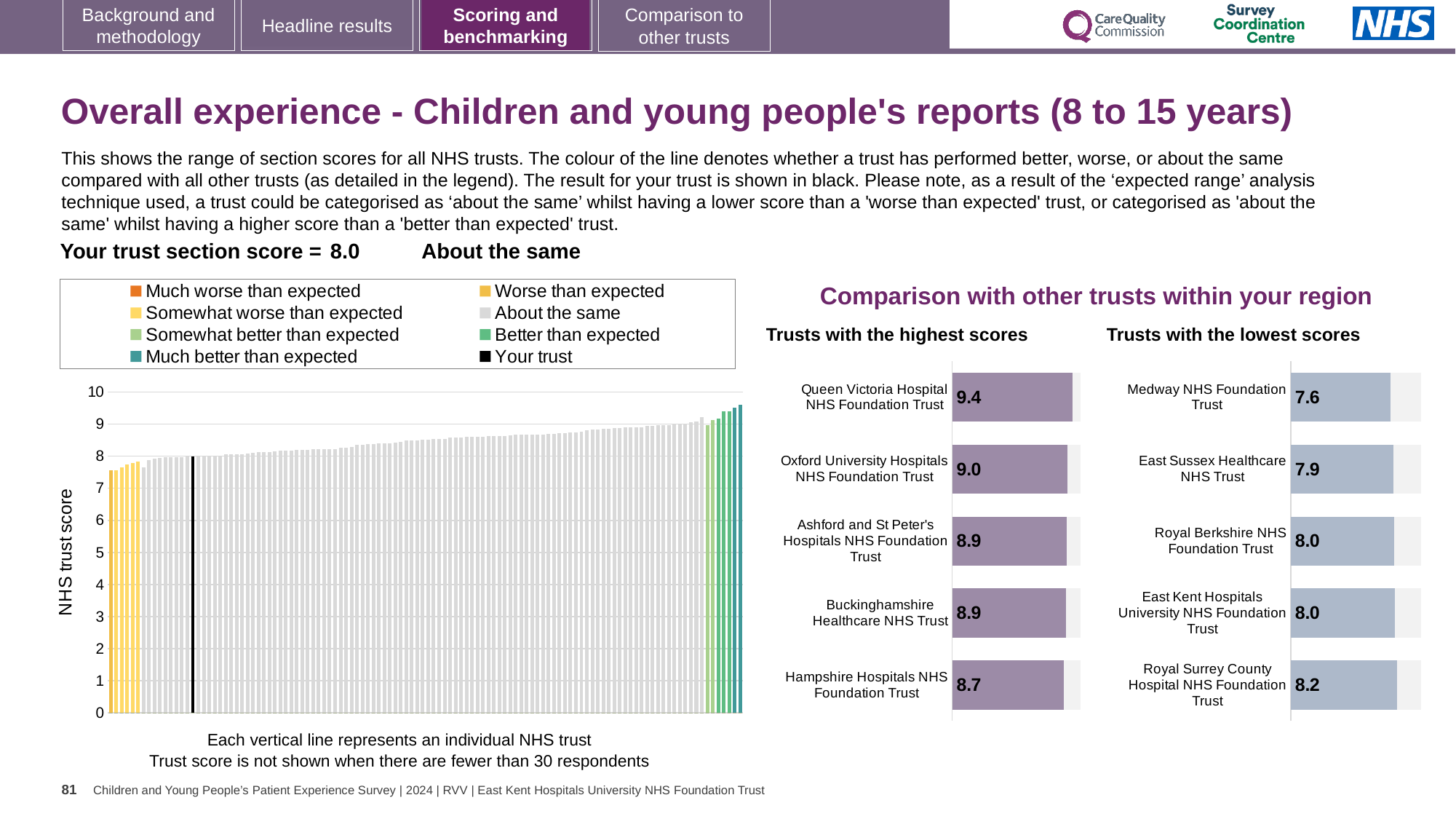
In the 'Trusts with the lowest scores' chart, which trust has the highest score? Royal Surrey County Hospital NHS Foundation Trust In the 'Trusts with the highest scores' chart, what is the score for Hampshire Hospitals NHS Foundation Trust? 8.7 In the large 'NHS trust score' chart on the left, do the bar values rise or fall from left to right? rise How many trusts are shown in the 'Trusts with the highest scores' chart? 5 In the 'Trusts with the lowest scores' chart, what is the score for Medway NHS Foundation Trust? 7.6 In the large 'NHS trust score' chart on the left, is the value of the leftmost bar greater or less than 8? less In the 'Trusts with the highest scores' chart, what is the difference between the scores of Queen Victoria Hospital NHS Foundation Trust and Hampshire Hospitals NHS Foundation Trust? 0.7 In the 'Trusts with the lowest scores' chart, what is the difference between the scores of Royal Surrey County Hospital NHS Foundation Trust and Medway NHS Foundation Trust? 0.6 In the 'Trusts with the lowest scores' chart, which has the larger score: Medway NHS Foundation Trust or East Sussex Healthcare NHS Trust? East Sussex Healthcare NHS Trust How many entries does the legend above the large 'NHS trust score' chart list? 8 In the 'Trusts with the highest scores' chart, what is the score for Queen Victoria Hospital NHS Foundation Trust? 9.4 In the 'Trusts with the lowest scores' chart, which trust has the lowest score? Medway NHS Foundation Trust